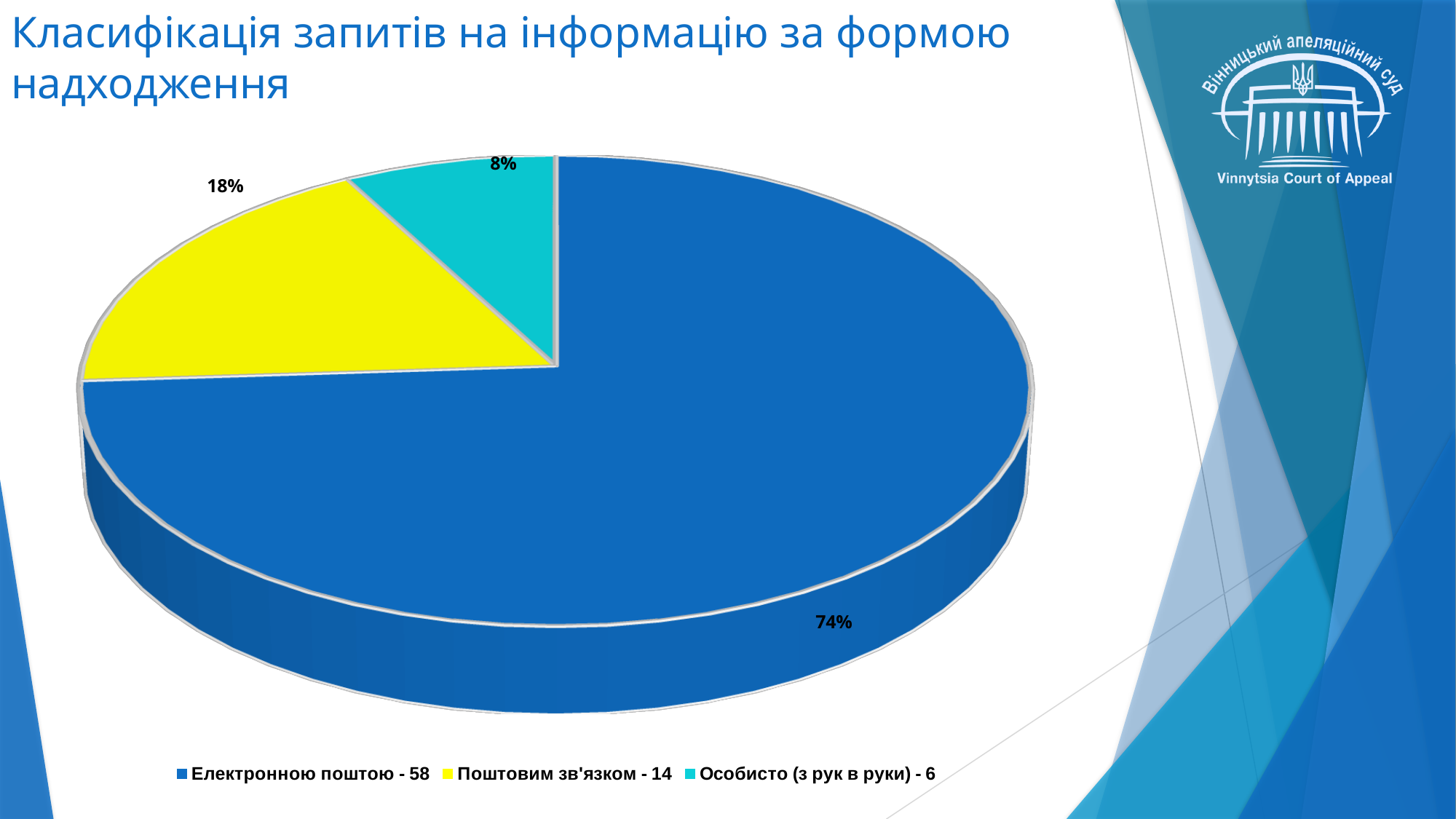
What kind of chart is shown on the slide? Pie chart How many slices does the pie chart have? 3 What share of the pie does the slice for "Електронною поштою - 58" represent? 74% What share of the pie does the slice for "Поштовим зв'язком - 14" represent? 18% What is the difference in percentage points between the "Поштовим зв'язком" slice and the "Особисто (з рук в руки)" slice? 10 Which category has the largest slice of the pie? Електронною поштою - 58 What colour is the slice for "Поштовим зв'язком - 14"? Yellow Which slice is larger: "Поштовим зв'язком" or "Особисто (з рук в руки)"? Поштовим зв'язком What is the title of the slide containing the chart? Класифікація запитів на інформацію за формою надходження What share of the pie does the slice for "Особисто (з рук в руки) - 6" represent? 8% What is the difference in percentage points between the "Електронною поштою" slice and the "Поштовим зв'язком" slice? 56 Which category has the smallest slice of the pie? Особисто (з рук в руки) - 6